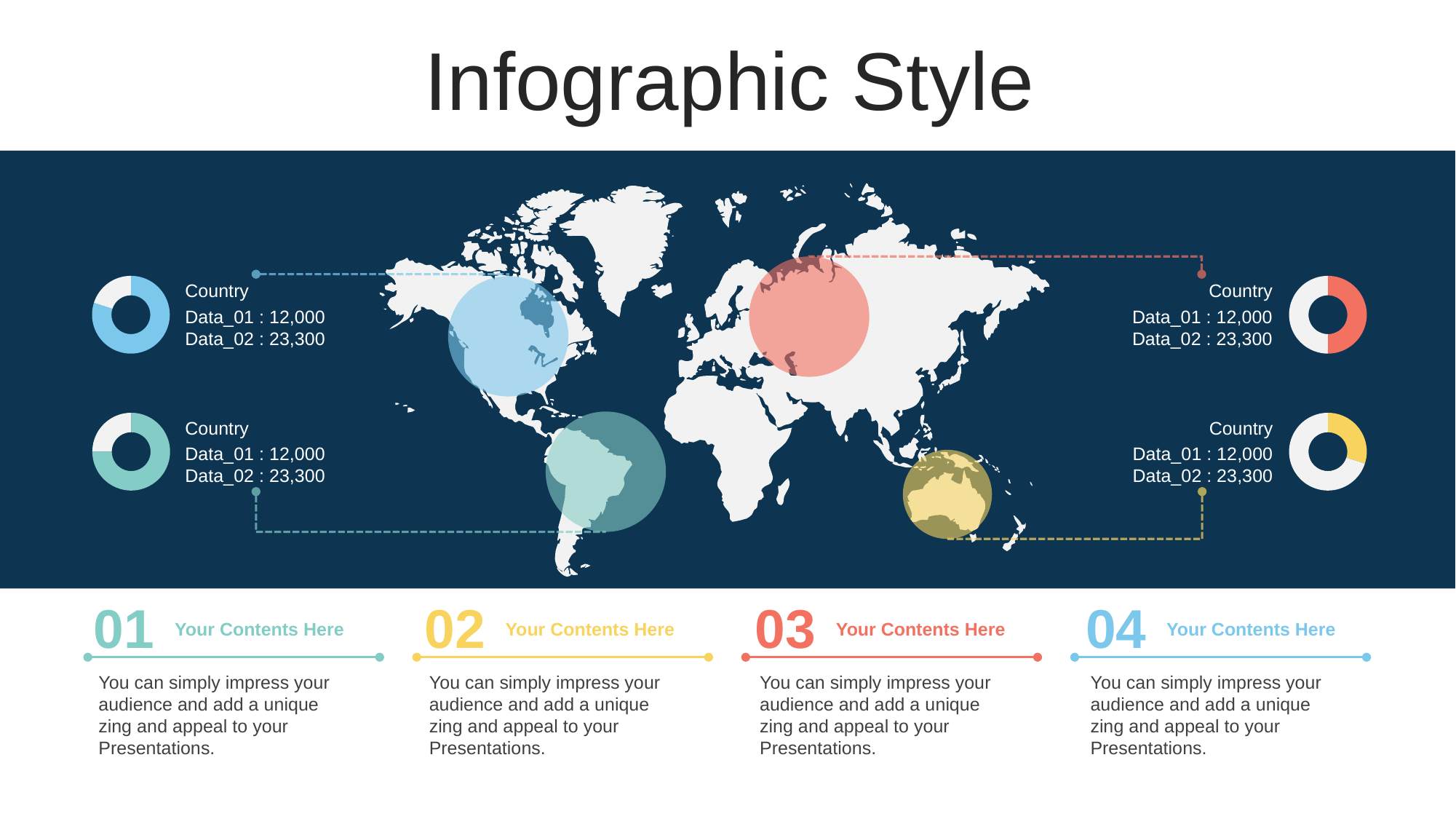
For the top-left donut chart, what is the value printed for Data_02? 23,300 What kind of charts are the four small charts flanking the world map? Donut (pie) charts What label is given for the category next to each donut chart? Country For the top-left donut chart, what is the total of Data_01 and Data_02? 35,300 For the bottom-right donut chart, what is the value printed for Data_02? 23,300 For the bottom-right donut chart, is the value for Data_01 greater or less than 20,000? less What colour is the highlighted segment of the top-right donut chart? Red For the top-right donut chart, which is larger, Data_01 or Data_02? Data_02 How many donut charts are shown on the slide? 4 For the top-left donut chart, what is the value printed for Data_01? 12,000 How many data series (segments) does each donut chart show? 2 For the bottom-left donut chart, what is the difference between Data_02 and Data_01? 11,300